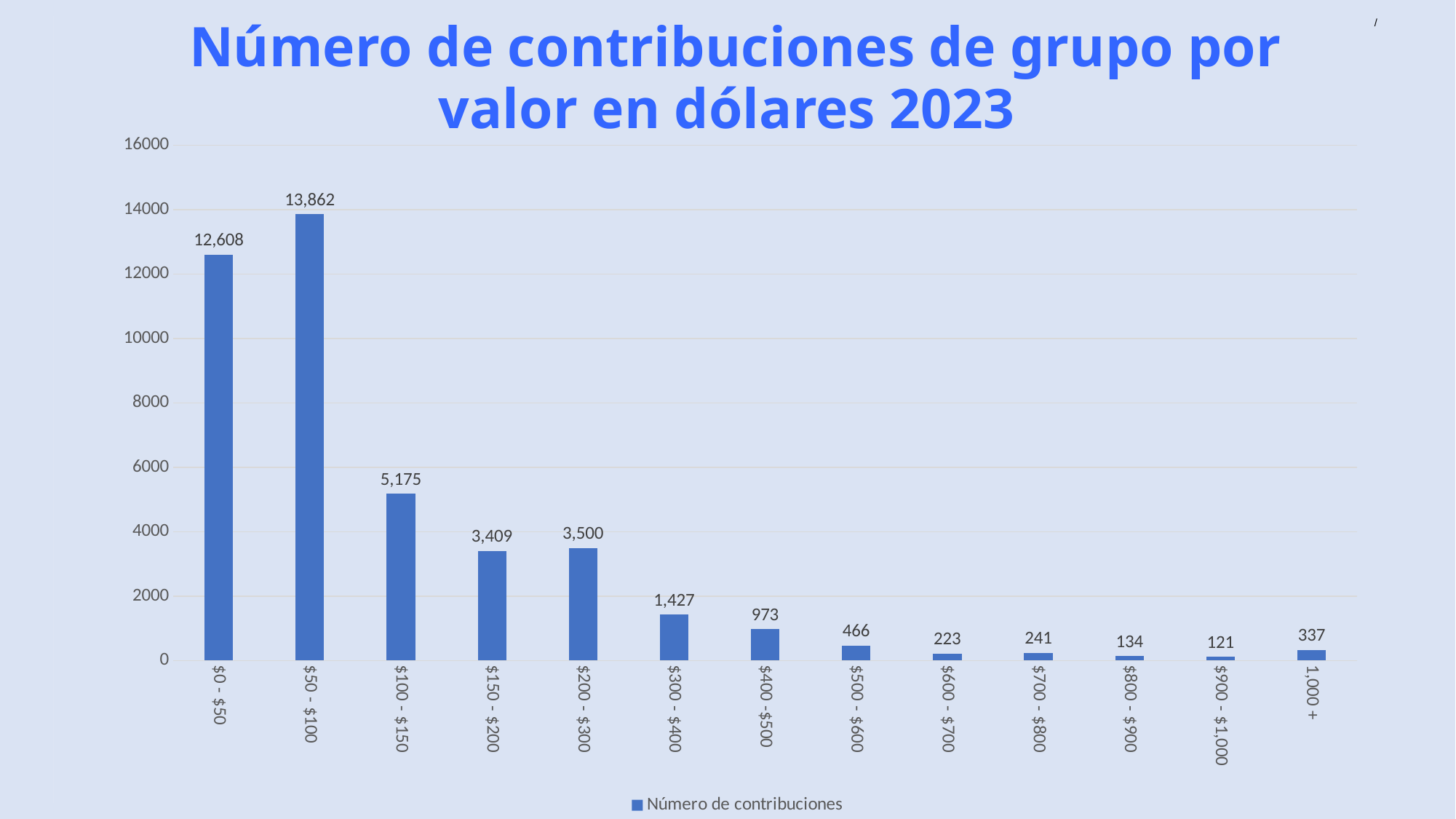
How many series does the legend list? 1 Which dollar range has the highest number of contributions? $50 - $100 Is the value for $100 - $150 greater or less than 6000? less Which dollar range has the lowest number of contributions? $900 - $1,000 How many dollar ranges are shown on the x axis? 13 What kind of chart is shown on the slide? Bar chart Which has more contributions: $150 - $200 or $200 - $300? $200 - $300 What is the title of the chart? Número de contribuciones de grupo por valor en dólares 2023 What is the number of contributions for the $50 - $100 range? 13,862 What is the difference between the number of contributions for $50 - $100 and $0 - $50? 1,254 What is the number of contributions for the 1,000 + range? 337 What is the number of contributions for the $400 - $500 range? 973